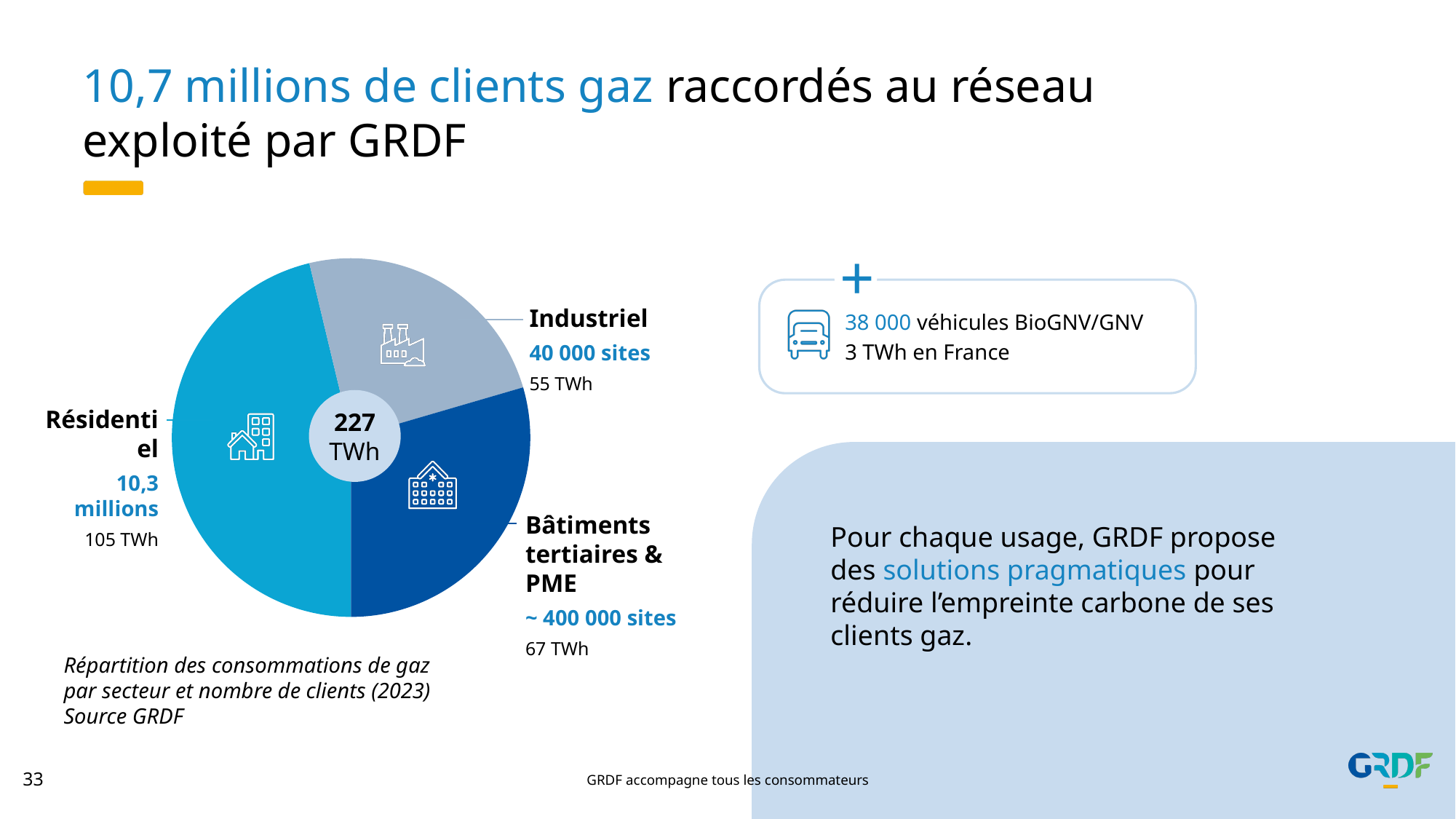
Which sector has the largest gas consumption in the pie chart? Résidentiel Which consumes more gas, Bâtiments tertiaires & PME or Industriel? Bâtiments tertiaires & PME Which sector has the smallest gas consumption in the pie chart? Industriel What is the gas consumption for the Résidentiel sector in the pie chart? 105 TWh What total gas consumption is shown in the centre of the pie chart? 227 TWh How many sectors (slices) does the pie chart show? 3 How many sites are indicated for the Industriel sector next to the pie chart? 40 000 sites What kind of chart is shown on the slide? pie chart What is the difference in gas consumption between the Résidentiel and Industriel sectors? 50 TWh What is the difference in gas consumption between Bâtiments tertiaires & PME and Industriel? 12 TWh What is the gas consumption for Bâtiments tertiaires & PME in the pie chart? 67 TWh What is the gas consumption for the Industriel sector in the pie chart? 55 TWh